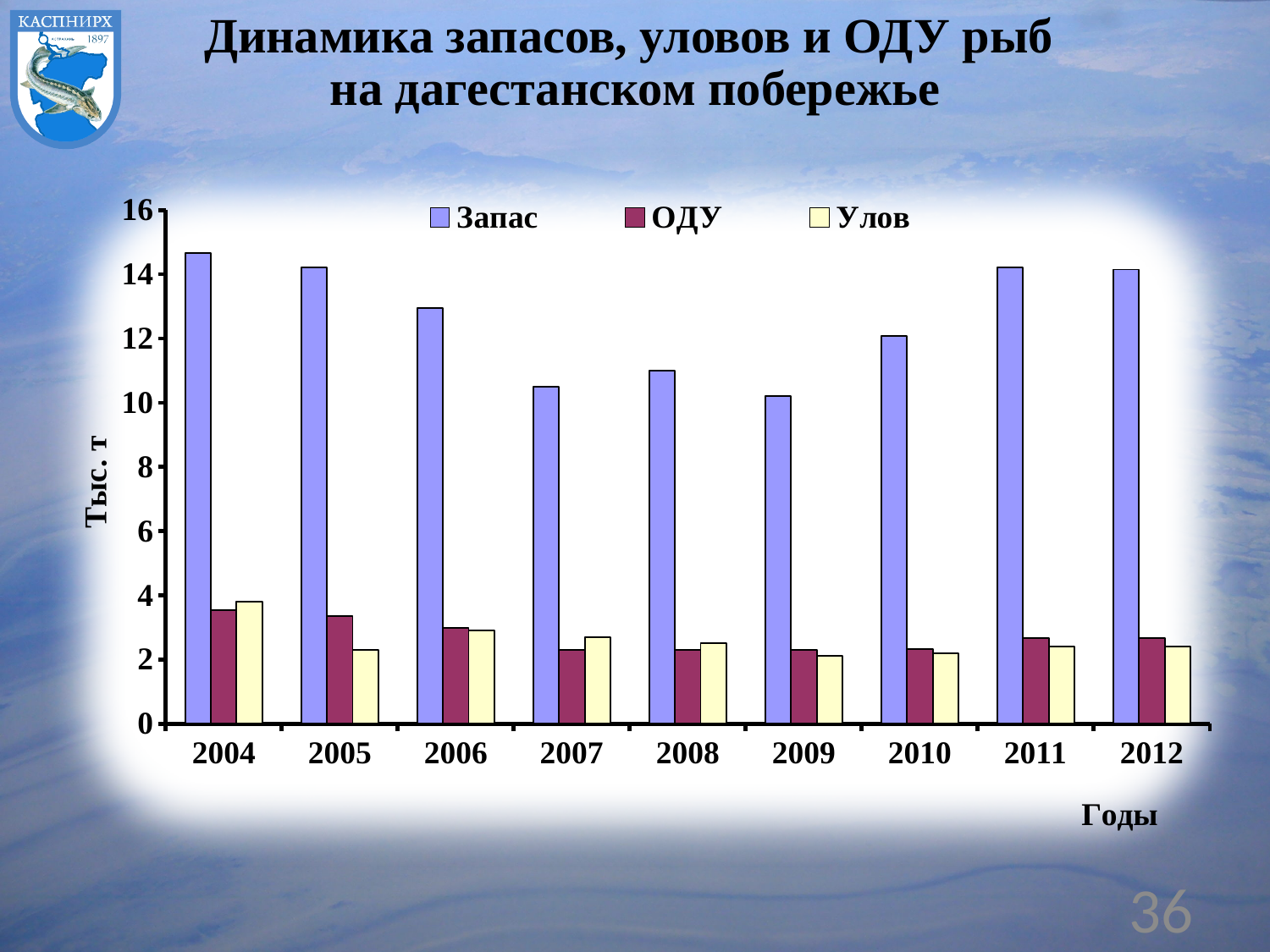
Is the Запас value for 2006 greater or less than 14? less What kind of chart is shown on the slide? bar chart In which year is the Улов value highest? 2004 How many years are shown on the x axis? 9 How many series does the legend list? 3 Which is larger in 2005, the ОДУ value or the Улов value? ОДУ Is the Запас value for 2008 greater or less than 12? less Is the Запас value for 2004 greater or less than 14? greater In which year is the Запас value highest? 2004 Does the Запас value rise or fall from 2004 to 2007? fall What is the label on the vertical axis? Тыс. т